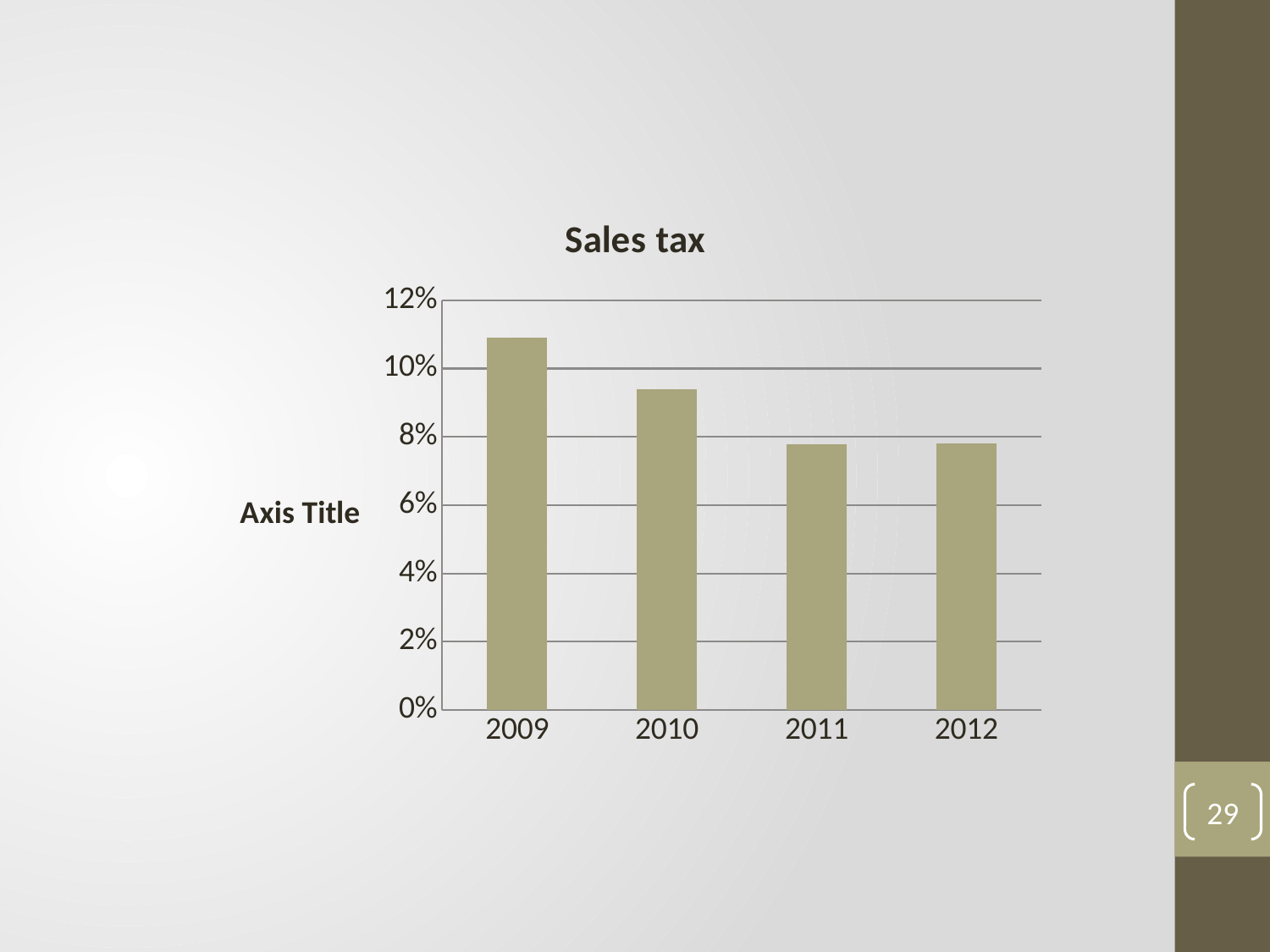
Is the value for 2011 greater or less than 8%? less Is the value for 2012 greater or less than 6%? greater Which is larger, the value for 2010 or the value for 2011? 2010 Which year has the highest sales tax value? 2009 What kind of chart is shown on the slide? bar chart Is the value for 2010 greater or less than 8%? greater Do the values generally rise or fall from 2009 to 2012? fall What is the title of the chart? Sales tax How many years are shown on the x axis of the chart? 4 Which is larger, the value for 2009 or the value for 2010? 2009